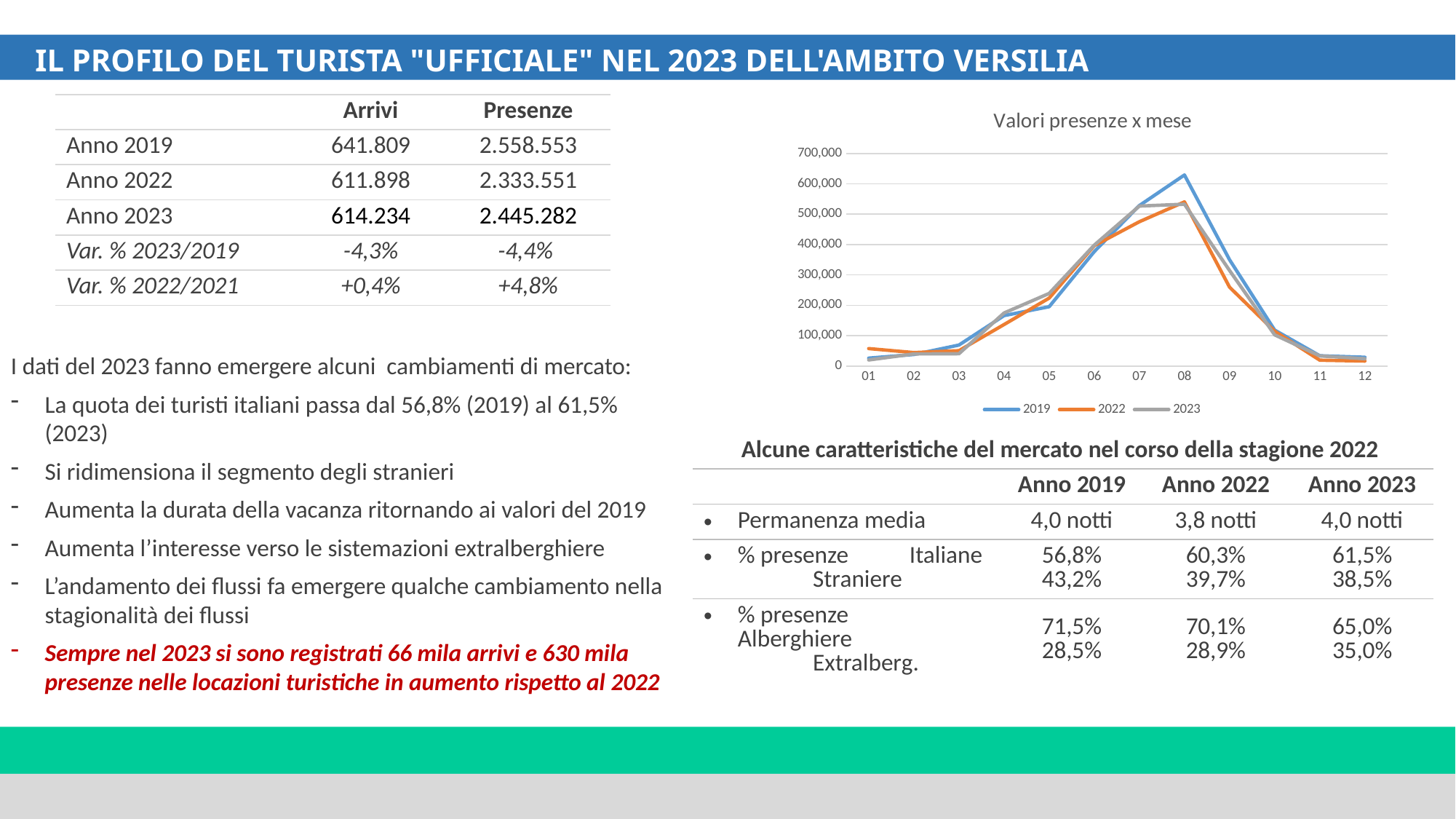
In the "Valori presenze x mese" chart, is the 2019 value for month 08 greater or less than 600,000? greater In the "Valori presenze x mese" chart, do the values for 2019 rise or fall from month 08 to month 12? fall In the "Valori presenze x mese" chart, is the 2023 value for month 11 greater or less than 100,000? less How many series does the legend of the "Valori presenze x mese" chart list? 3 In the "Valori presenze x mese" chart, which series is higher in month 09, 2019 or 2022? 2019 In the "Valori presenze x mese" chart, which month has the highest value for the 2019 series? 08 Which series is drawn in orange in the "Valori presenze x mese" chart? 2022 In the "Valori presenze x mese" chart, is the 2022 value for month 08 greater or less than 600,000? less What kind of chart is "Valori presenze x mese"? line chart In the "Valori presenze x mese" chart, which series is higher in month 08, 2019 or 2022? 2019 What is the title of the line chart on the slide? Valori presenze x mese How many months are plotted along the x axis of the "Valori presenze x mese" chart? 12